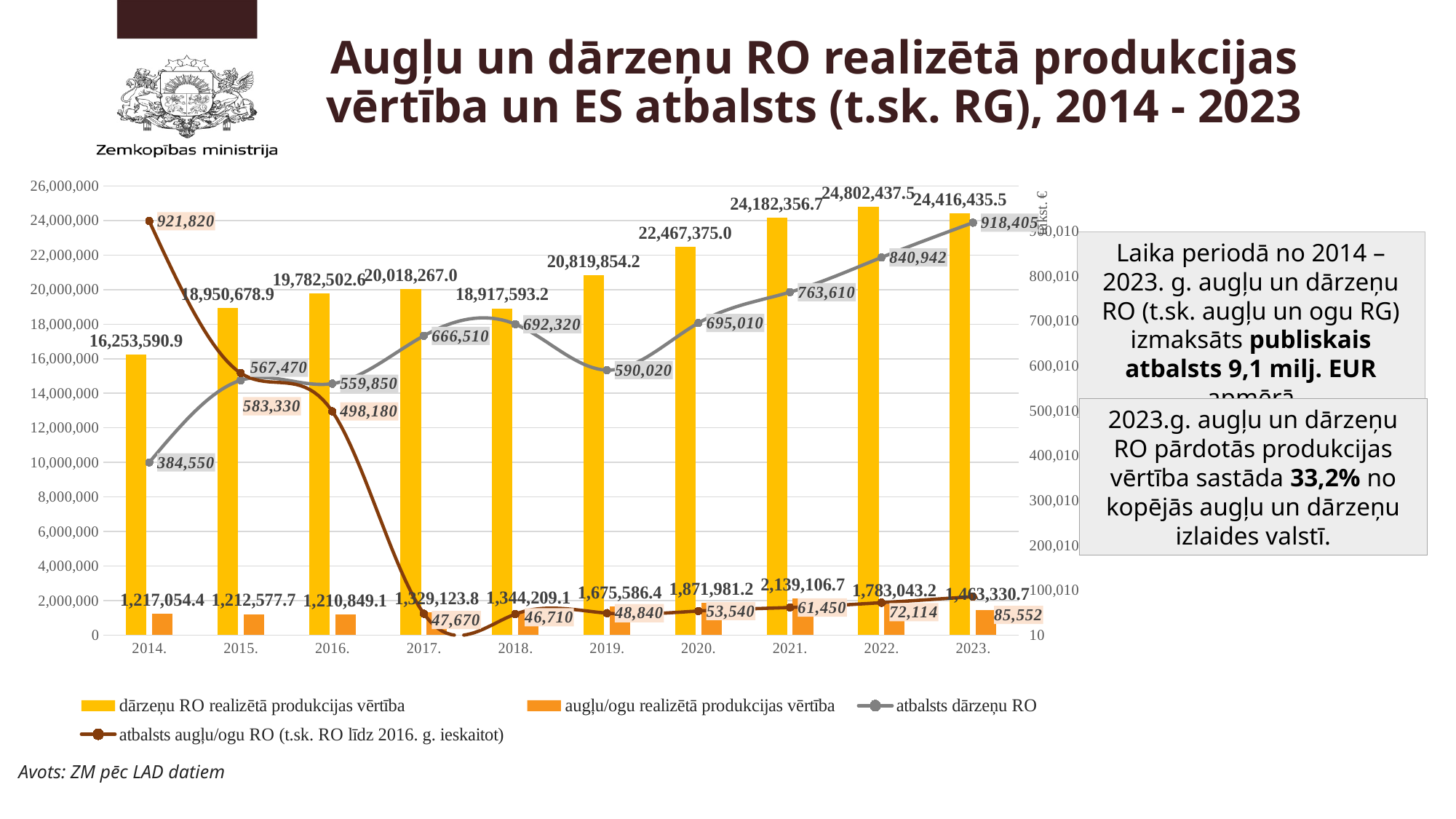
Which is larger in 2014: atbalsts augļu/ogu RO or atbalsts dārzeņu RO? atbalsts augļu/ogu RO What is the difference between atbalsts dārzeņu RO in 2023 and in 2022? 77,463 What is the value of dārzeņu RO realizētā produkcijas vērtība for 2014? 16,253,590.9 How many series does the chart legend list? 4 In which year is atbalsts dārzeņu RO lowest? 2014. What is the value of atbalsts dārzeņu RO for 2023? 918,405 How many years are shown on the x axis of the chart? 10 In which year is dārzeņu RO realizētā produkcijas vērtība highest? 2022. What kind of chart is shown on the slide? Combined bar and line chart What is the value of augļu/ogu realizētā produkcijas vērtība for 2021? 2,139,106.7 Does atbalsts augļu/ogu RO rise or fall from 2014 to 2017? Fall What is the value of atbalsts augļu/ogu RO for 2017? 47,670